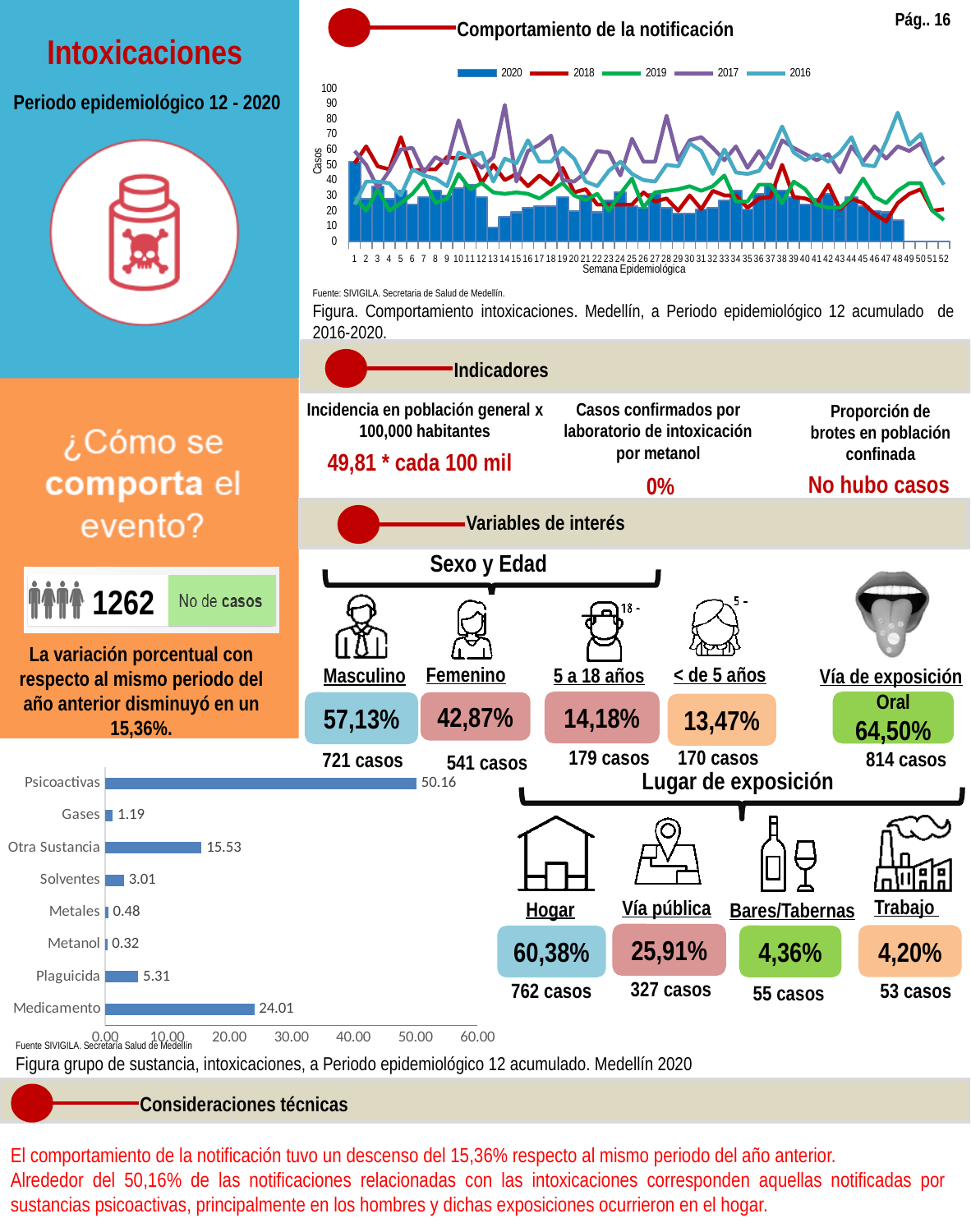
In the bottom-left bar chart of substance groups, what is the value for Psicoactivas? 50.16 In the bottom-left bar chart of substance groups, which category has the highest value? Psicoactivas In the bottom-left bar chart of substance groups, which is larger, Otra Sustancia or Solventes? Otra Sustancia How many categories are shown in the bottom-left bar chart of substance groups? 8 In the bottom-left bar chart of substance groups, what is the value for Medicamento? 24.01 In the bottom-left bar chart of substance groups, what is the difference between the values for Psicoactivas and Medicamento? 26.15 In the 'Comportamiento de la notificación' chart, is the value for 2020 at week 13 greater or less than 20? less What kind of chart is the bottom-left chart of substance groups? Bar chart In the 'Comportamiento de la notificación' chart, what is the label of the x axis? Semana Epidemiológica How many series does the legend of the 'Comportamiento de la notificación' chart list? 5 In the bottom-left bar chart of substance groups, what is the value for Plaguicida? 5.31 In the bottom-left bar chart of substance groups, which category has the lowest value? Metanol